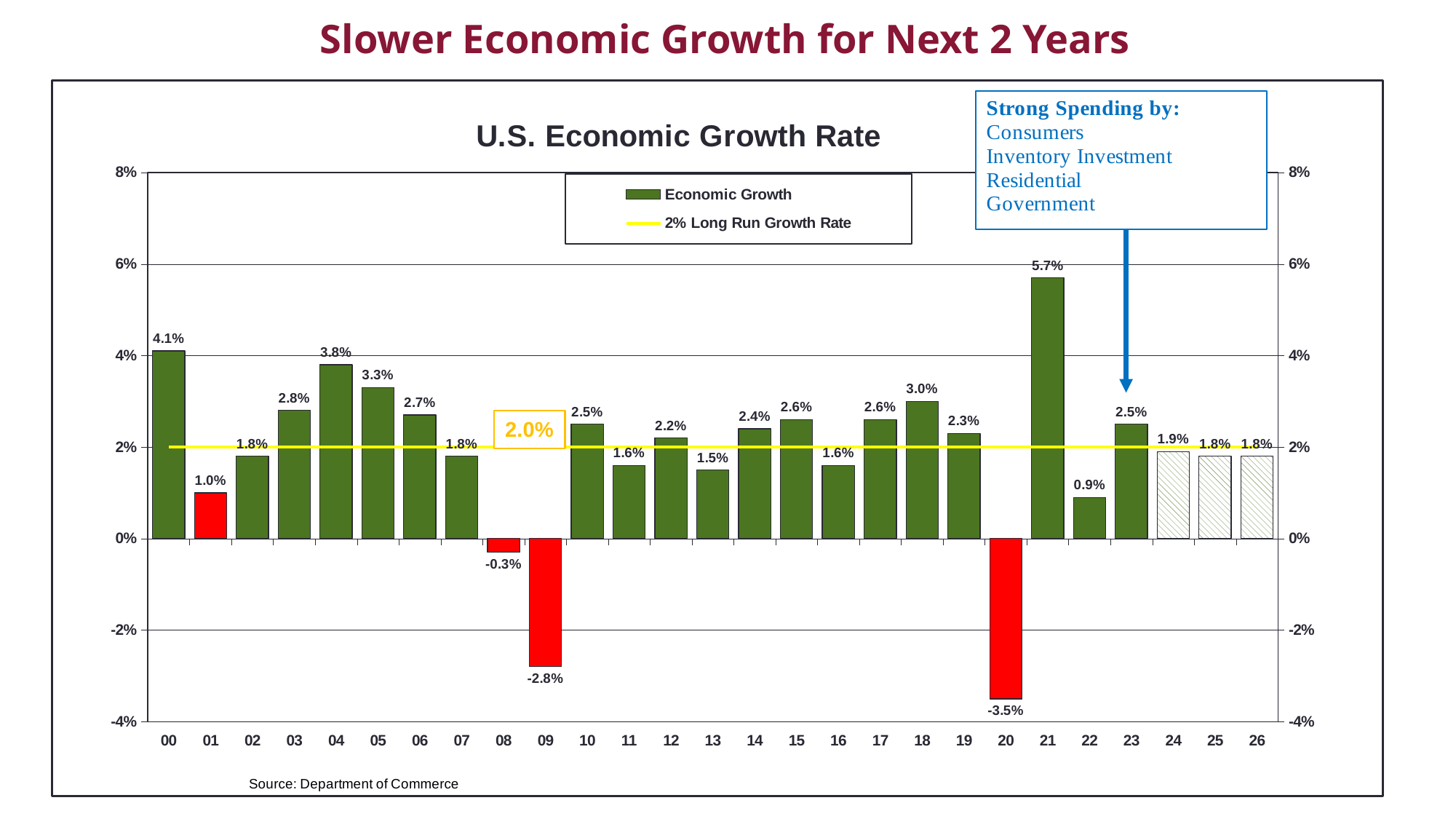
Do the growth rates rise or fall from 2023 to 2026? Fall Which year has the highest economic growth rate on the chart? 21 What is the economic growth rate shown for 2009? -2.8% What is the economic growth rate shown for 2024? 1.9% How many entries does the legend list? 2 How many years are shown on the x axis of the chart? 27 What is the economic growth rate shown for 2021? 5.7% What kind of chart is used to show the U.S. Economic Growth Rate? Bar chart What is the difference between the growth rate in 2021 and the growth rate in 2022? 4.8% Which year had a higher growth rate, 2004 or 2005? 04 What is the value of the long run growth rate line shown on the chart? 2.0% Which year has the lowest economic growth rate on the chart? 20